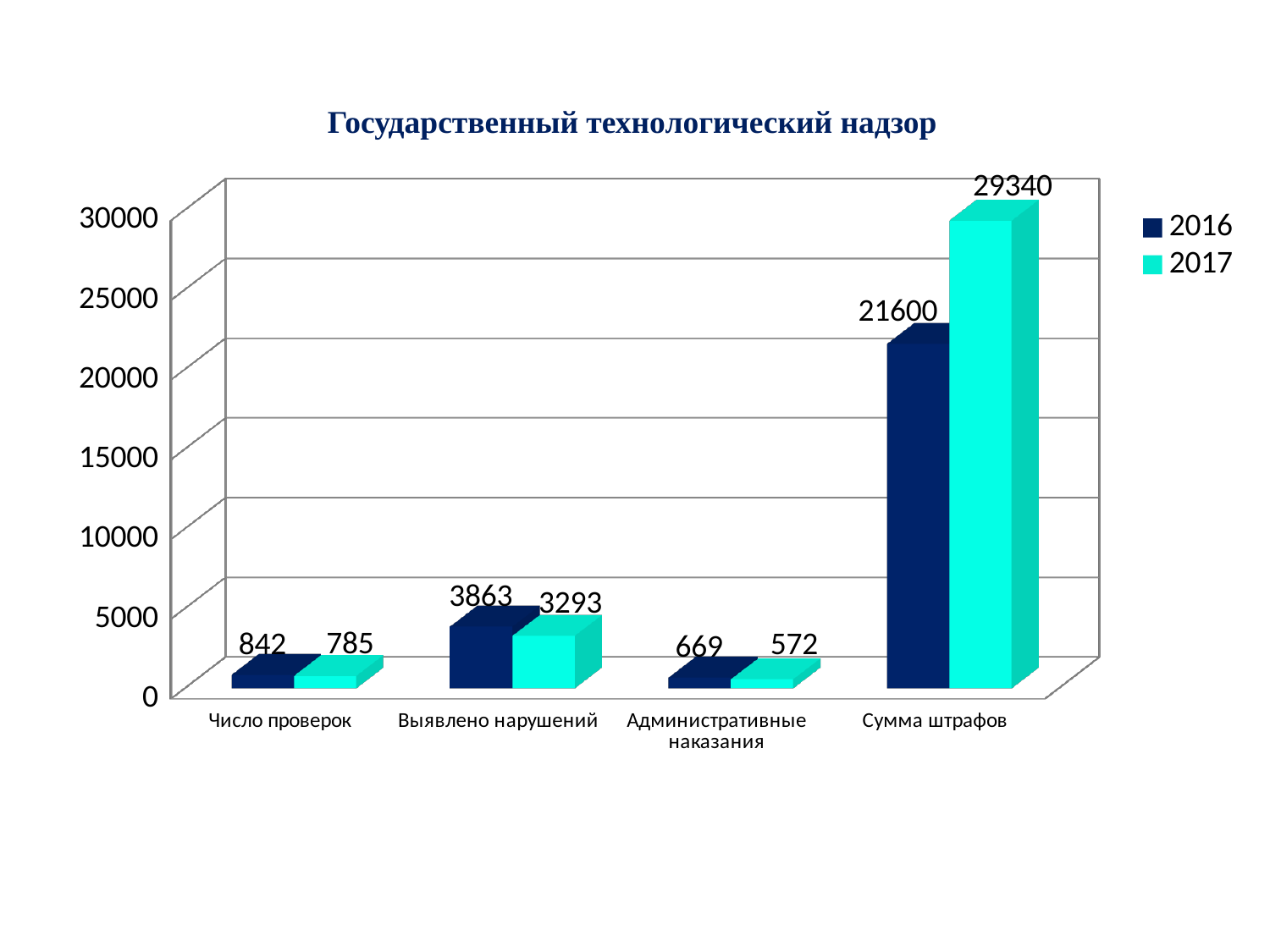
Which category has the highest value for 2017? Сумма штрафов How many series does the legend list? 2 What is the difference between the 2017 and 2016 values for Сумма штрафов? 7740 What is the value for Административные наказания in 2017? 572 Which is larger for Число проверок: the 2016 value or the 2017 value? 2016 What is the value for Сумма штрафов in 2017? 29340 What is the value for Число проверок in 2016? 842 What type of chart is shown on the slide? bar chart Is the 2016 value for Сумма штрафов greater or less than 20000? greater Which category has the lowest value for 2016? Административные наказания How many categories are shown on the x axis? 4 What is the difference between the 2016 and 2017 values for Выявлено нарушений? 570